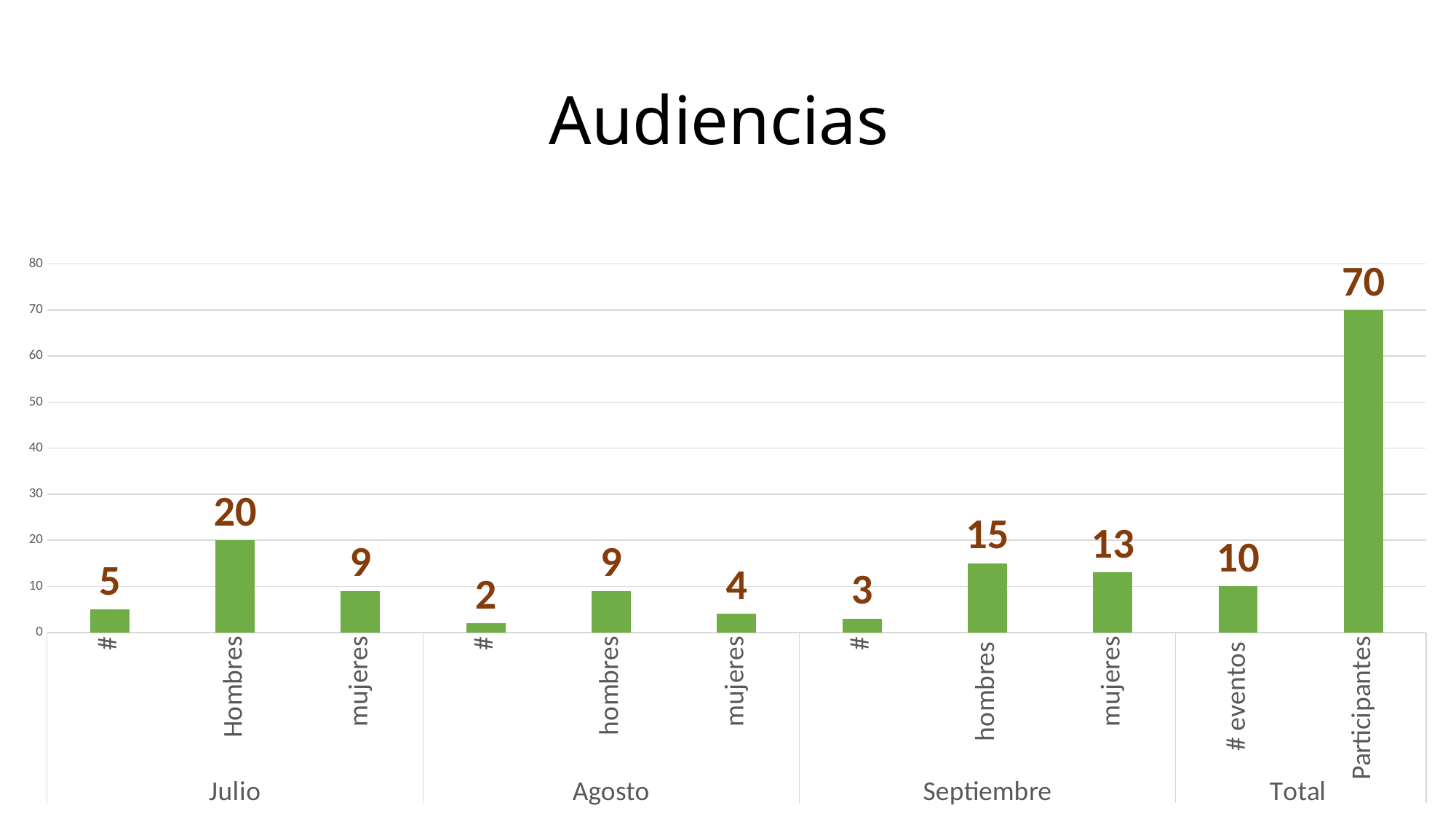
Which bar has the lowest value? # in Agosto Which is larger, Hombres in Julio or hombres in Septiembre? Hombres in Julio What is the title of the chart? Audiencias Is the value for Participantes greater or less than 60? greater What is the value for Hombres in Julio? 20 What kind of chart is shown? Bar chart What is the value for mujeres in Agosto? 4 What is the value for # eventos under Total? 10 What is the value for Participantes under Total? 70 How many bars are plotted in the chart? 11 What is the difference between hombres and mujeres in Septiembre? 2 Which bar has the highest value? Participantes